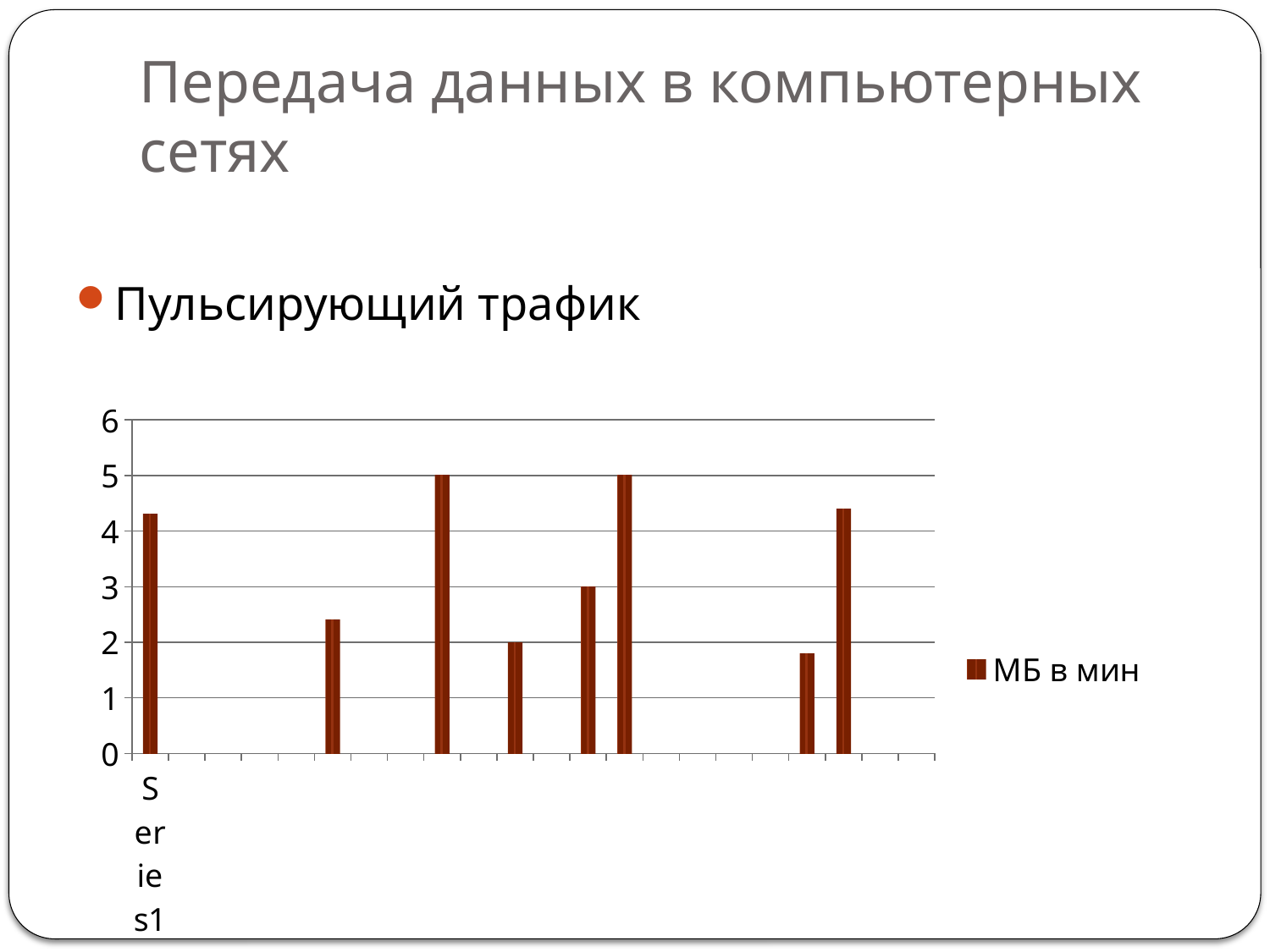
Do the bar values rise steadily, fall steadily, or fluctuate along the x axis? fluctuate Is the value of the bar labelled Series1 greater or less than the highest bar value of 5? less How many bars in the chart reach the value 5? 2 How many bars are plotted in the chart? 8 What is the maximum value shown on the vertical axis? 6 What is the name of the series shown in the chart legend? МБ в мин What is the highest value reached by any bar in the chart? 5 What kind of chart is shown on the slide? Bar chart How many series does the chart legend list? 1 Is the value of the shortest bar in the chart greater or less than 2? less Is the value of the bar labelled Series1 greater or less than 4? greater